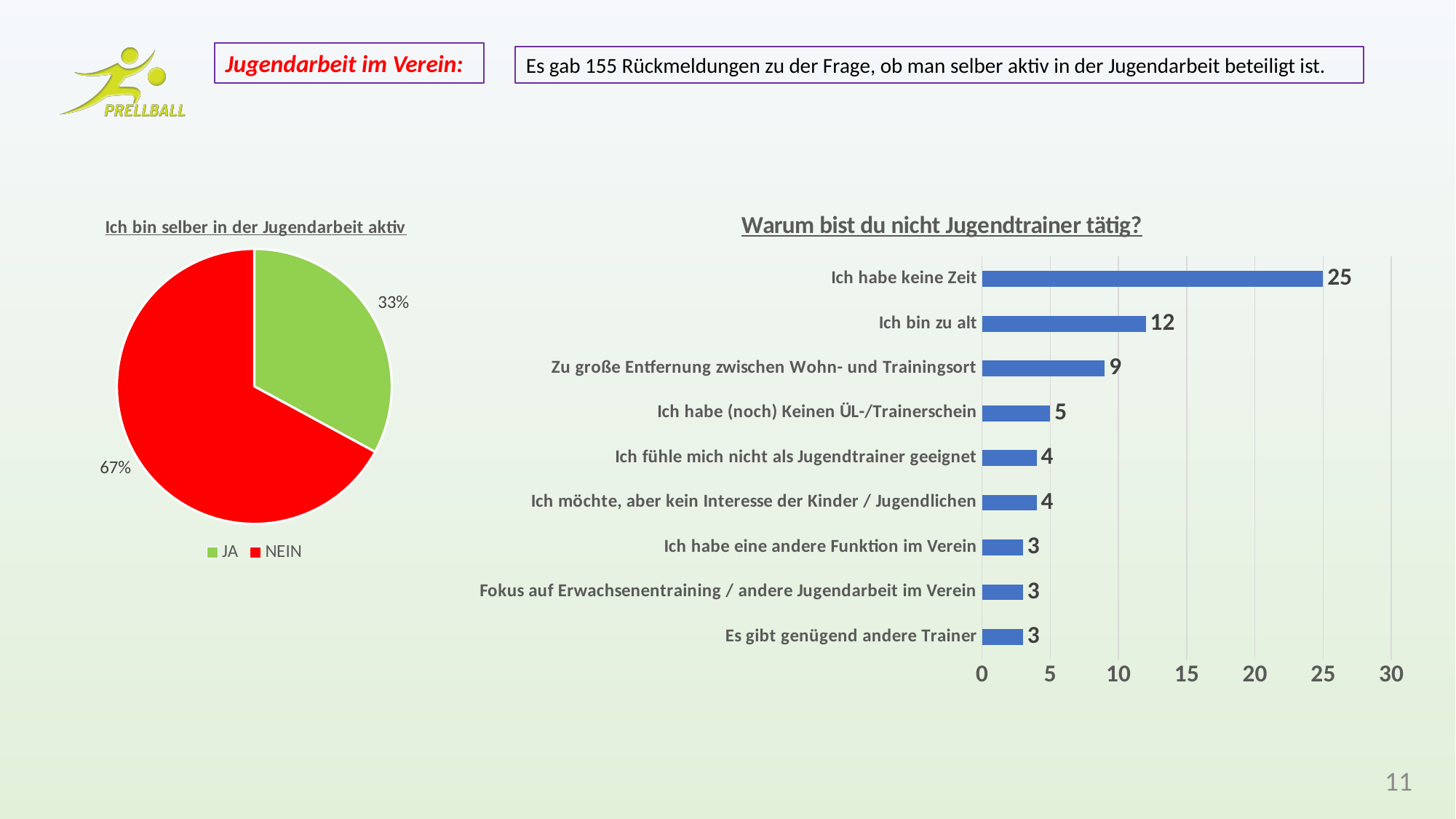
In the pie chart 'Ich bin selber in der Jugendarbeit aktiv', how many entries does the legend list? 2 In the chart 'Warum bist du nicht Jugendtrainer tätig?', which reason has the highest value? Ich habe keine Zeit In the pie chart 'Ich bin selber in der Jugendarbeit aktiv', what colour is the NEIN slice? Red In the chart 'Warum bist du nicht Jugendtrainer tätig?', what is the difference between 'Ich habe keine Zeit' and 'Ich bin zu alt'? 13 What kind of chart is 'Warum bist du nicht Jugendtrainer tätig?'? Bar chart In the chart 'Warum bist du nicht Jugendtrainer tätig?', what is the value for 'Zu große Entfernung zwischen Wohn- und Trainingsort'? 9 In the chart 'Warum bist du nicht Jugendtrainer tätig?', how many reasons are listed? 9 In the chart 'Warum bist du nicht Jugendtrainer tätig?', which is larger, 'Ich bin zu alt' or 'Ich habe (noch) Keinen ÜL-/Trainerschein'? Ich bin zu alt In the pie chart 'Ich bin selber in der Jugendarbeit aktiv', which answer has the larger slice, JA or NEIN? NEIN In the chart 'Warum bist du nicht Jugendtrainer tätig?', what is the value for 'Ich habe keine Zeit'? 25 In the pie chart 'Ich bin selber in der Jugendarbeit aktiv', what share of respondents answered NEIN? 67% In the pie chart 'Ich bin selber in der Jugendarbeit aktiv', what share of respondents answered JA? 33%